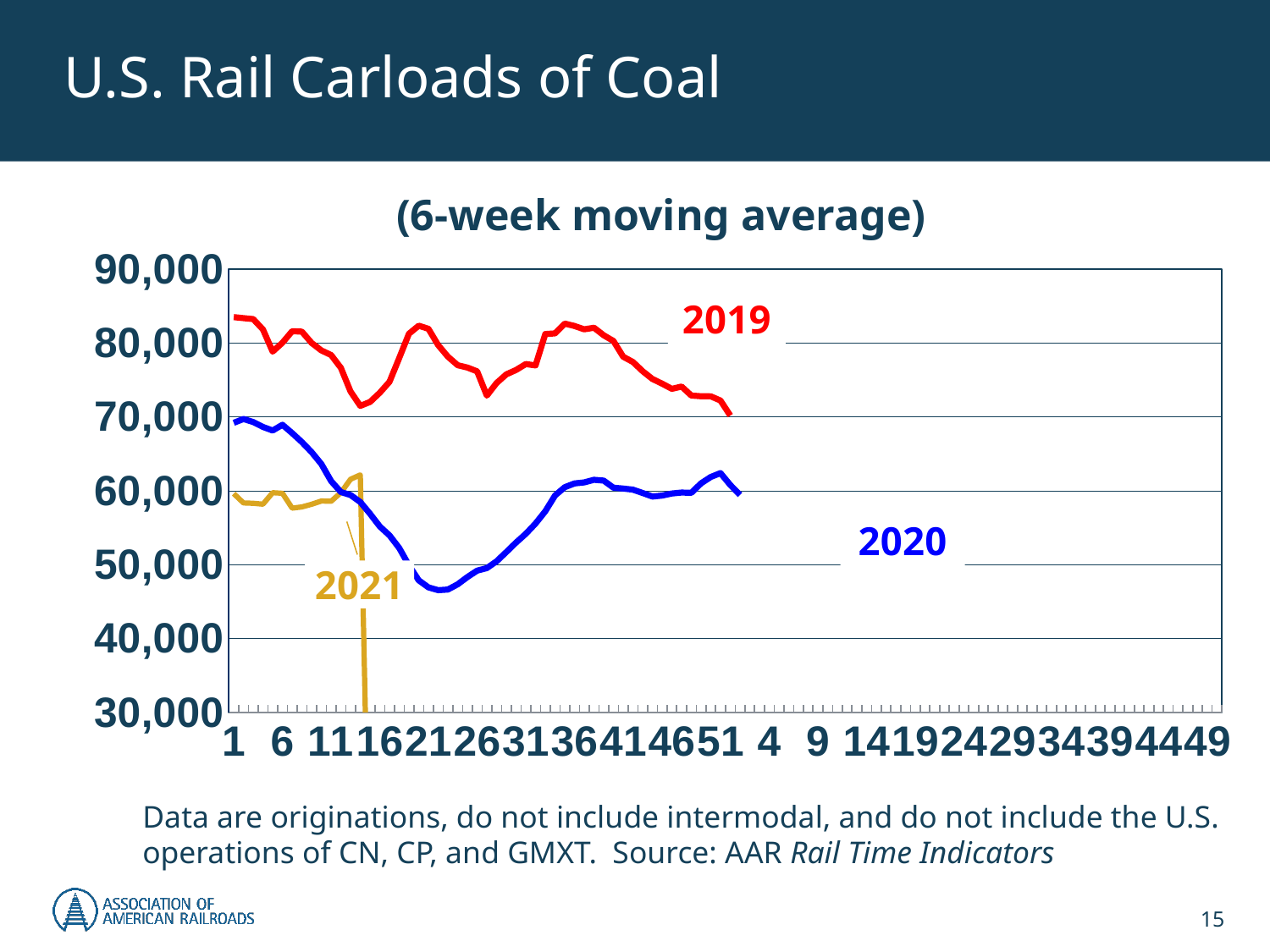
What is the subtitle shown above the chart? (6-week moving average) Is the value for 2019 at week 1 greater or less than 80,000? greater Is the lowest value of the 2020 series greater or less than 50,000? less Is the value for 2020 at week 1 greater or less than 70,000? less Does the 2019 series rise or fall between week 36 and week 51? fall Does the 2020 series rise or fall between week 21 and week 36? rise Which series has the highest values across the chart? 2019 Which years are plotted on the chart? 2019, 2020 and 2021 At week 1, which series is larger, 2019 or 2020? 2019 How many data series (years) are plotted on the chart? 3 What kind of chart is shown on the slide? line chart